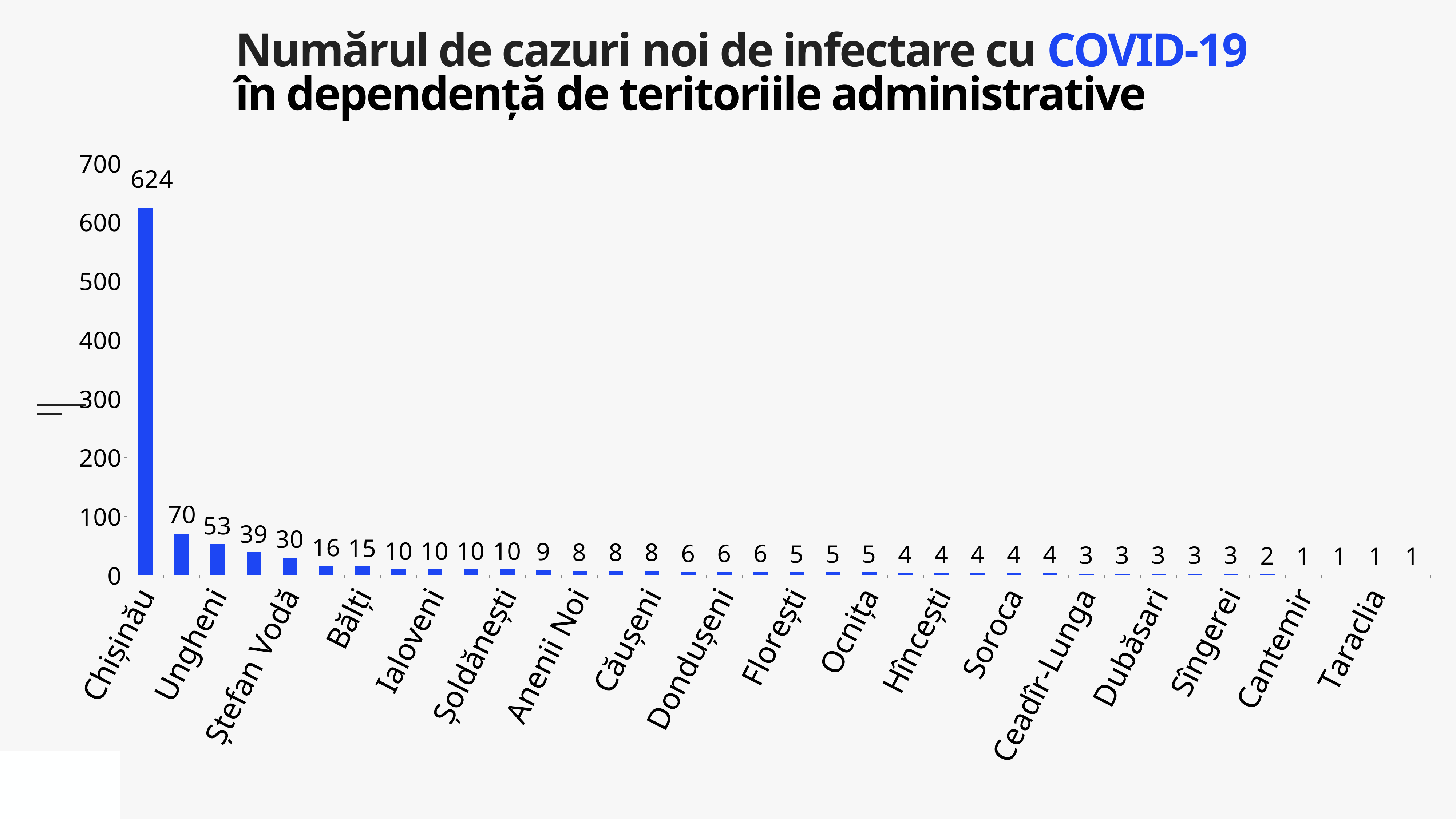
What is the difference between the highest bar (624) and the second highest bar (70)? 554 What is the number of new cases shown for Taraclia? 1 What is the value of the second highest bar in the chart? 70 Which has more new cases, Chișinău or Ungheni? Chișinău Is the value for Chișinău greater or less than 600? greater Which administrative territory has the highest number of new COVID-19 cases? Chișinău Do the values rise or fall from left to right along the x axis? fall What kind of chart is shown on the slide? bar chart What is the number of new cases shown for Chișinău? 624 What colour are the bars in the chart? blue How many bars are plotted in the chart? 36 What is the lowest value shown on any bar in the chart? 1